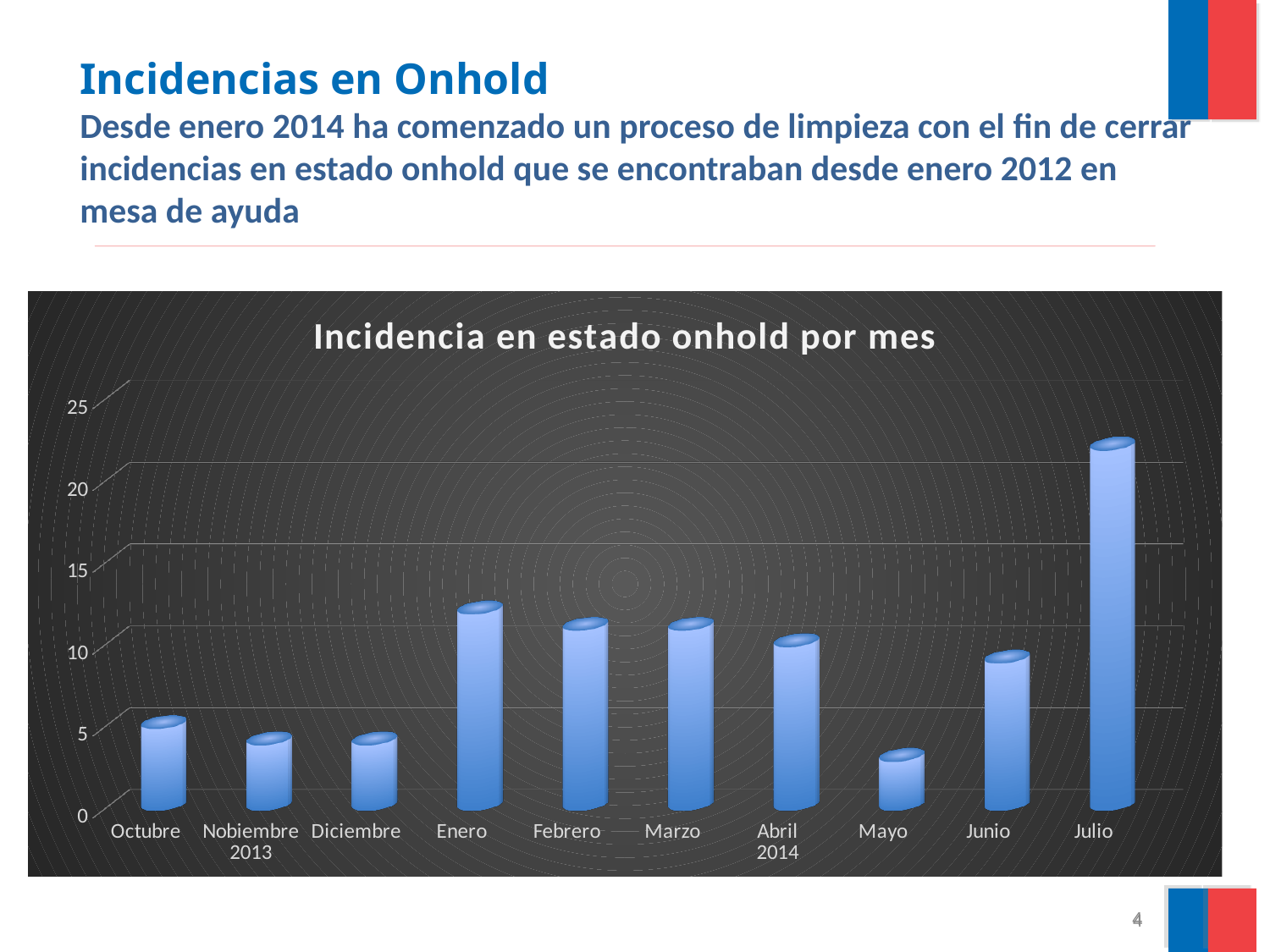
What kind of chart is shown on the slide? bar chart Is the value for Mayo greater or less than 5? less What is the title of the chart? Incidencia en estado onhold por mes Which is larger, the value for Mayo or the value for Junio? Junio Which month has the lowest number of incidents in onhold status? Mayo Which month has the highest number of incidents in onhold status? Julio Is the value for Julio greater or less than 20? greater Is the value for Nobiembre greater or less than 5? less Do the values rise or fall from Enero to Mayo? fall Which is larger, the value for Enero or the value for Octubre? Enero How many months are plotted on the chart? 10